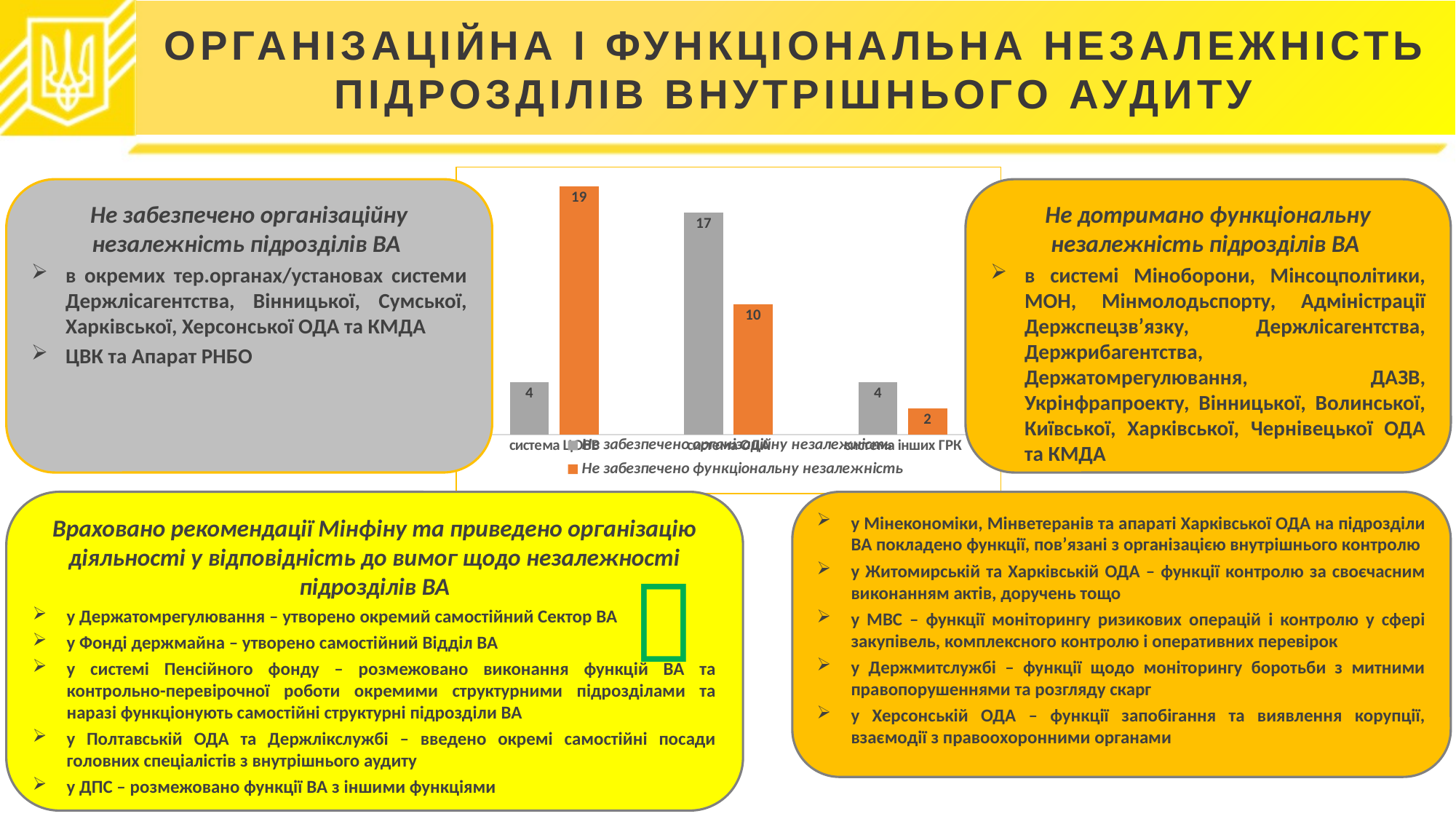
What is the value of the gray series (Не забезпечено організаційну незалежність) for система ОДА? 17 What is the value of the orange series (Не забезпечено функціональну незалежність) for система інших ГРК? 2 Which category has the highest value for the orange series (Не забезпечено функціональну незалежність)? система ЦОВВ What is the value of the orange series (Не забезпечено функціональну незалежність) for система ОДА? 10 For система ЦОВВ, which series has the larger value: the gray one or the orange one? the orange one (Не забезпечено функціональну незалежність) What is the value of the gray series (Не забезпечено організаційну незалежність) for система ЦОВВ? 4 How many series does the chart legend list? 2 What is the value of the orange series (Не забезпечено функціональну незалежність) for система ЦОВВ? 19 What kind of chart is shown on the slide? bar chart Which category has the lowest value for the orange series (Не забезпечено функціональну незалежність)? система інших ГРК What is the difference between the gray and orange values for система ОДА? 7 How many categories are shown on the x axis of the chart? 3